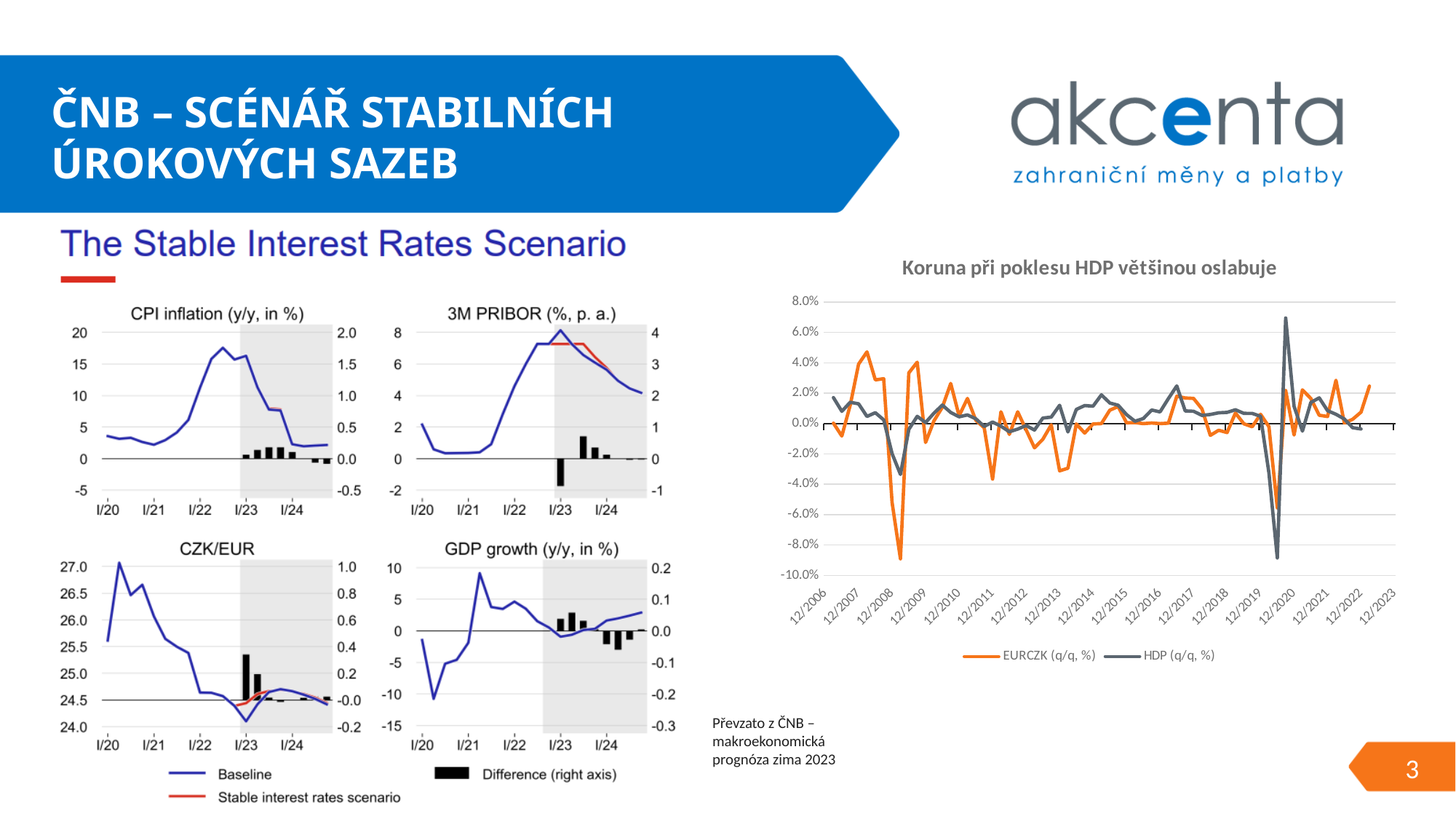
How many series does the legend of the chart "Koruna při poklesu HDP většinou oslabuje" list? 2 In the "CZK/EUR" chart, is the highest value of the Baseline line greater or less than 26.5? greater In the "3M PRIBOR (%, p. a.)" chart, is the peak of the Baseline line greater or less than 6? greater In the "CPI inflation (y/y, in %)" chart, is the peak of the Baseline line greater or less than 15? greater How many small charts are shown under the heading "The Stable Interest Rates Scenario"? 4 In the "CPI inflation (y/y, in %)" chart, does the Baseline line rise or fall between I/23 and I/24? fall In the chart "Koruna při poklesu HDP většinou oslabuje", which series is drawn in orange? EURCZK (q/q, %) In the charts under "The Stable Interest Rates Scenario", what colour is the "Stable interest rates scenario" line? red What kind of chart is the chart titled "Koruna při poklesu HDP většinou oslabuje"? line chart